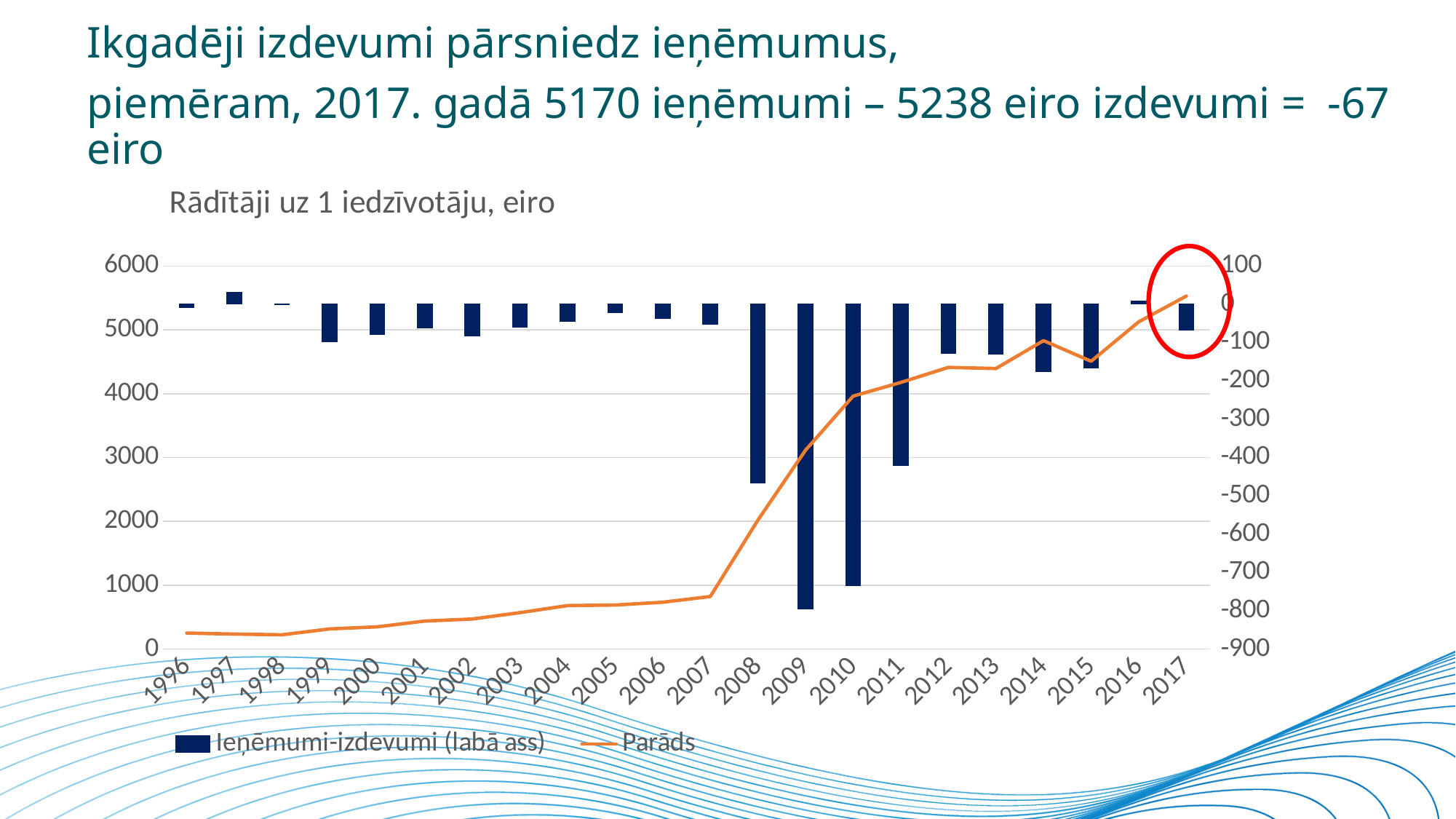
In which year does the Ieņēmumi-izdevumi bar reach its lowest (most negative) value? 2009 According to the slide, what is the Ieņēmumi-izdevumi value for 2017? -67 eiro How many series does the legend list? 2 Is the Parāds value for 2017 greater or less than 5000? greater Which year has the higher Parāds value, 2014 or 2015? 2014 In which year is the Parāds line at its highest? 2017 Is the Ieņēmumi-izdevumi value for 2009 greater or less than -700? less Is the Ieņēmumi-izdevumi value for 2014 greater or less than -300? greater How many years are shown on the x axis? 22 What kind of chart is shown on the slide? A combined bar and line chart Does the Parāds line generally rise or fall from 1996 to 2017? rise